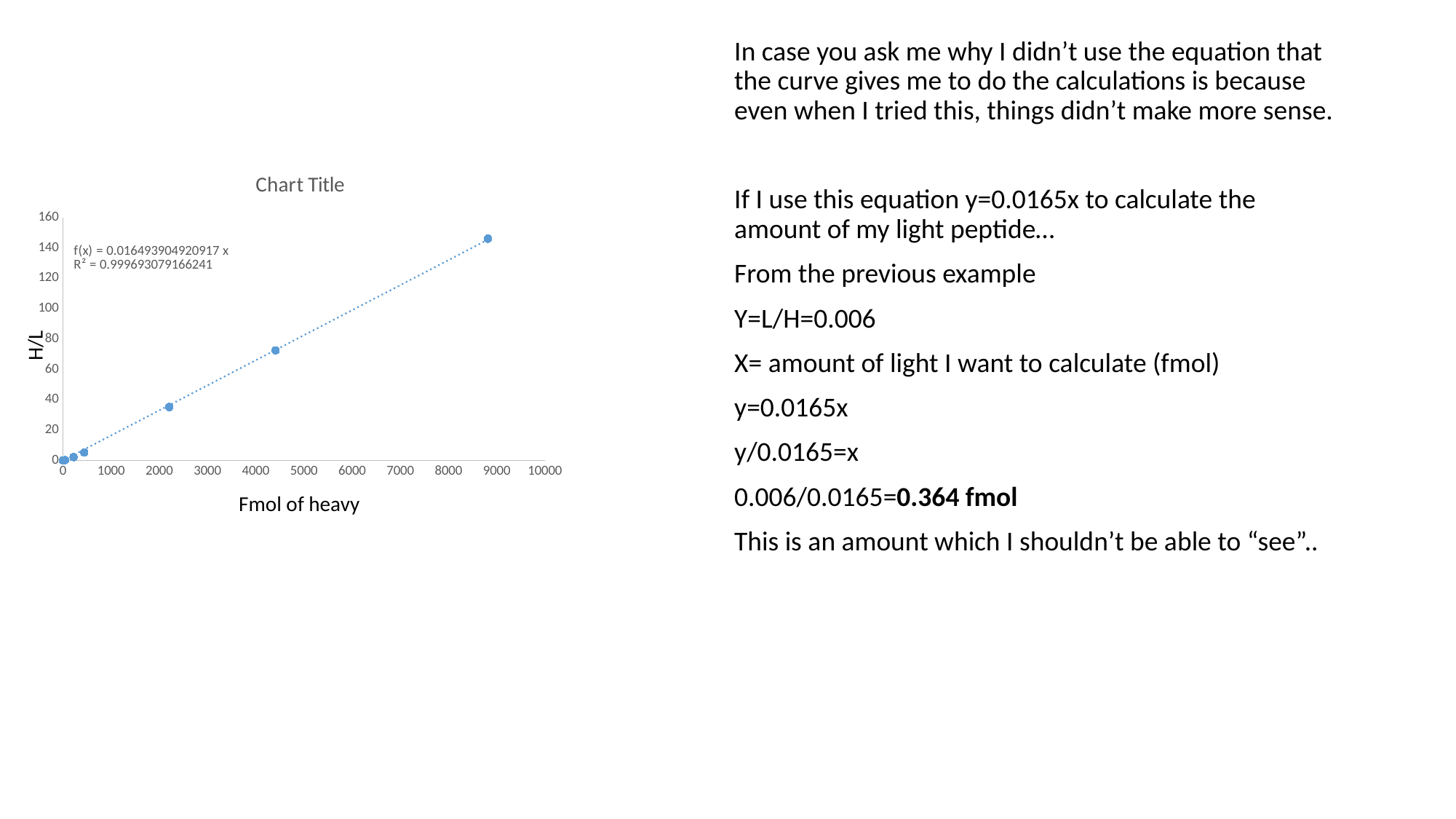
Do the H/L values rise or fall as Fmol of heavy increases? rise What kind of chart is shown on the slide? scatter chart What R² value is printed on the chart? 0.999693079166241 Is the H/L value for the point near 4400 fmol of heavy greater or less than 80? less Is the H/L value for the point near 8800 fmol of heavy greater or less than 120? greater What is the title of the chart? Chart Title What is the label of the y axis of the chart? H/L Is the H/L value for the point near 4400 fmol of heavy greater or less than 60? greater What is the label of the x axis of the chart? Fmol of heavy Which point has the highest H/L value: the one near 2200 or the one near 8800 fmol of heavy? the one near 8800 What is the trendline equation printed on the chart? f(x) = 0.016493904920917 x